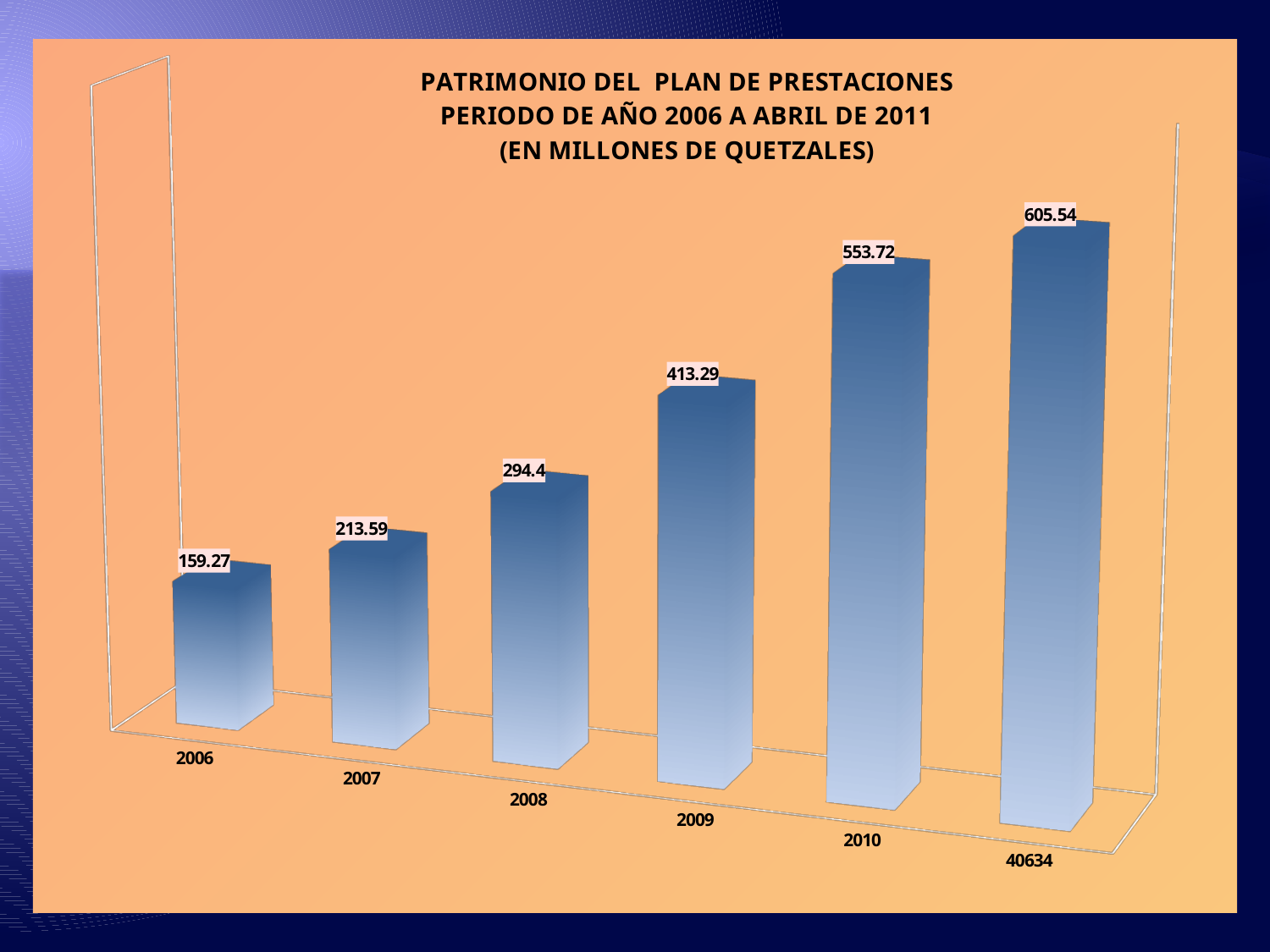
Do the values rise or fall from 2006 to the last category? Rise What is the difference between the values for 2010 and 2009? 140.43 Which category has the lowest value? 2006 What kind of chart is this? Bar chart Which category has the highest value? 40634 What is the value for 2010? 553.72 What is the value for 2008? 294.4 What is the value for the category labelled 40634? 605.54 How many categories are shown on the x axis? 6 What unit does the chart title say the values are in? Millones de quetzales Which is larger, the value for 2007 or the value for 2008? 2008 What is the value for 2006? 159.27